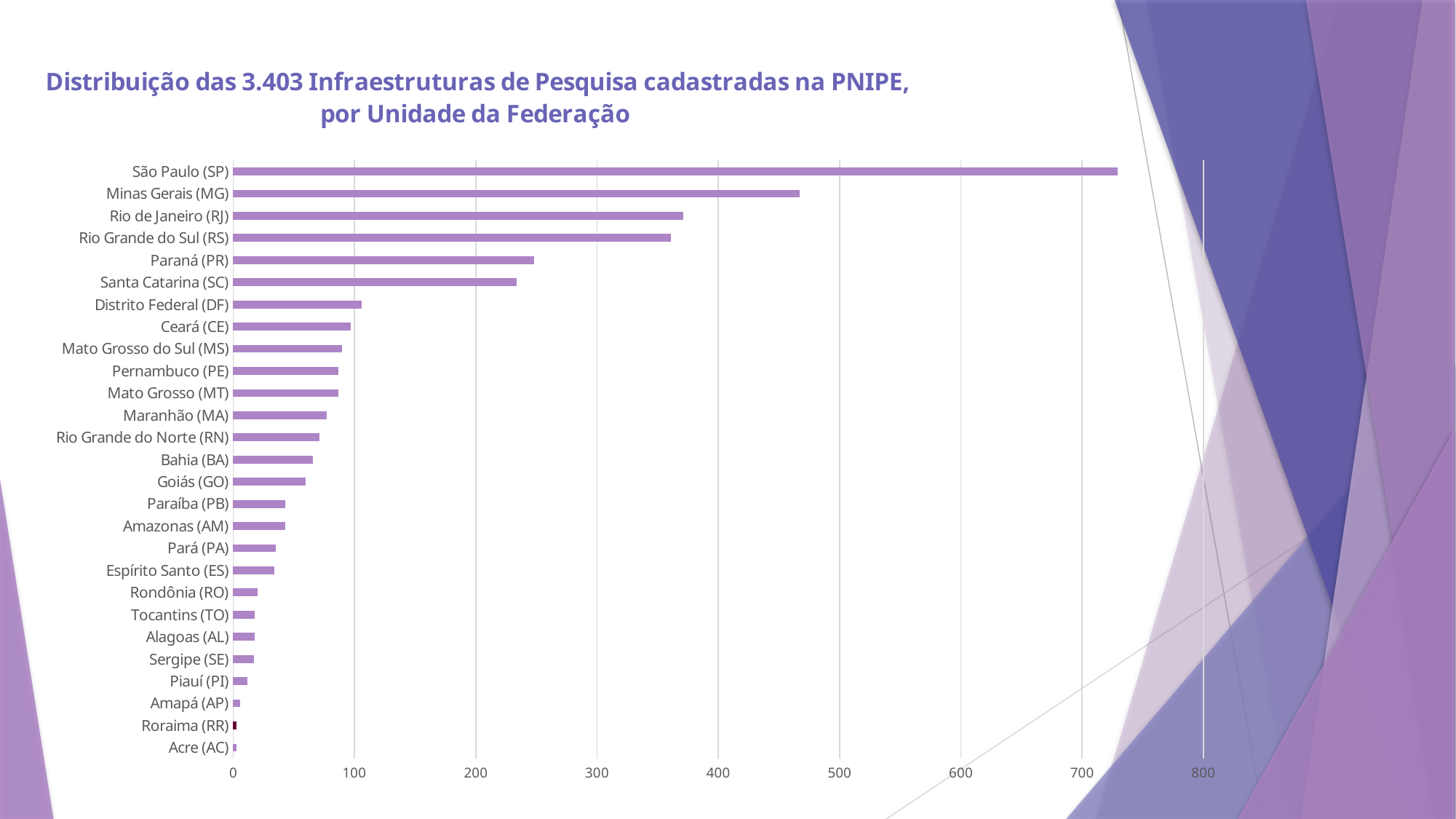
According to the chart title, how many research infrastructures are registered in the PNIPE? 3.403 What kind of chart is shown on the slide? bar chart Is the value for Mato Grosso do Sul (MS) greater or less than 100? less Which state has the highest number of research infrastructures on the chart? São Paulo (SP) Is the value for São Paulo (SP) greater or less than 700? greater Is the value for Rio Grande do Sul (RS) greater or less than 300? greater How many states (Unidades da Federação) are listed on the chart? 27 Which has a larger value, Minas Gerais (MG) or Rio de Janeiro (RJ)? Minas Gerais (MG) Do the bar values increase or decrease going from the top of the chart to the bottom? decrease